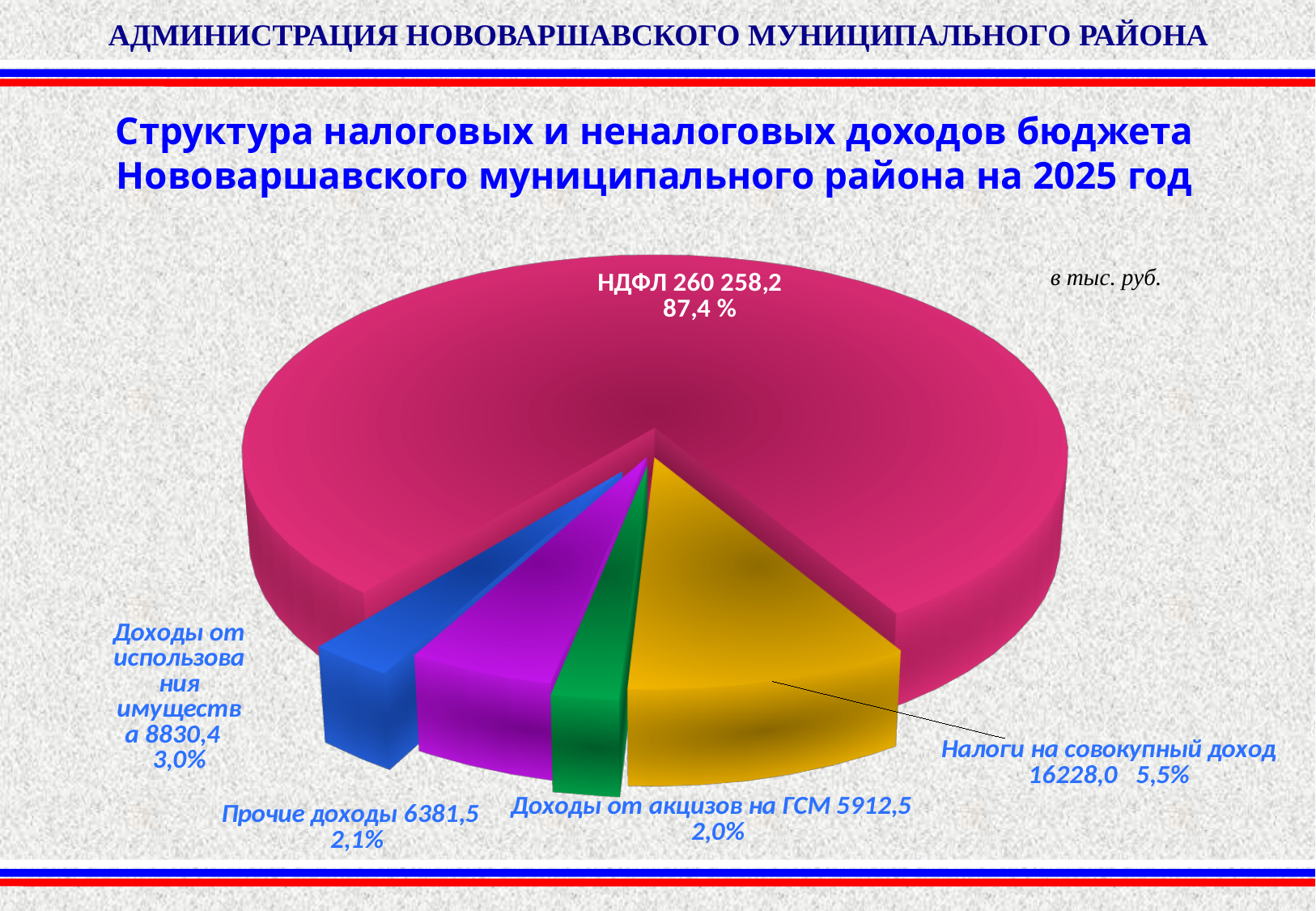
What share of the pie does Доходы от использования имущества represent? 3,0% What is the value shown for Прочие доходы? 6381,5 What is the value shown for НДФЛ? 260 258,2 Which is larger: Налоги на совокупный доход or Доходы от использования имущества? Налоги на совокупный доход What unit is stated for the values on the chart? в тыс. руб. What kind of chart is shown on the slide? pie chart What share of the pie does Доходы от акцизов на ГСМ represent? 2,0% How many slices does the pie chart have? 5 What is the value shown for Налоги на совокупный доход? 16228,0 What share of the pie does НДФЛ represent? 87,4 % Which category has the largest slice of the pie? НДФЛ Which category has the smallest slice of the pie? Доходы от акцизов на ГСМ